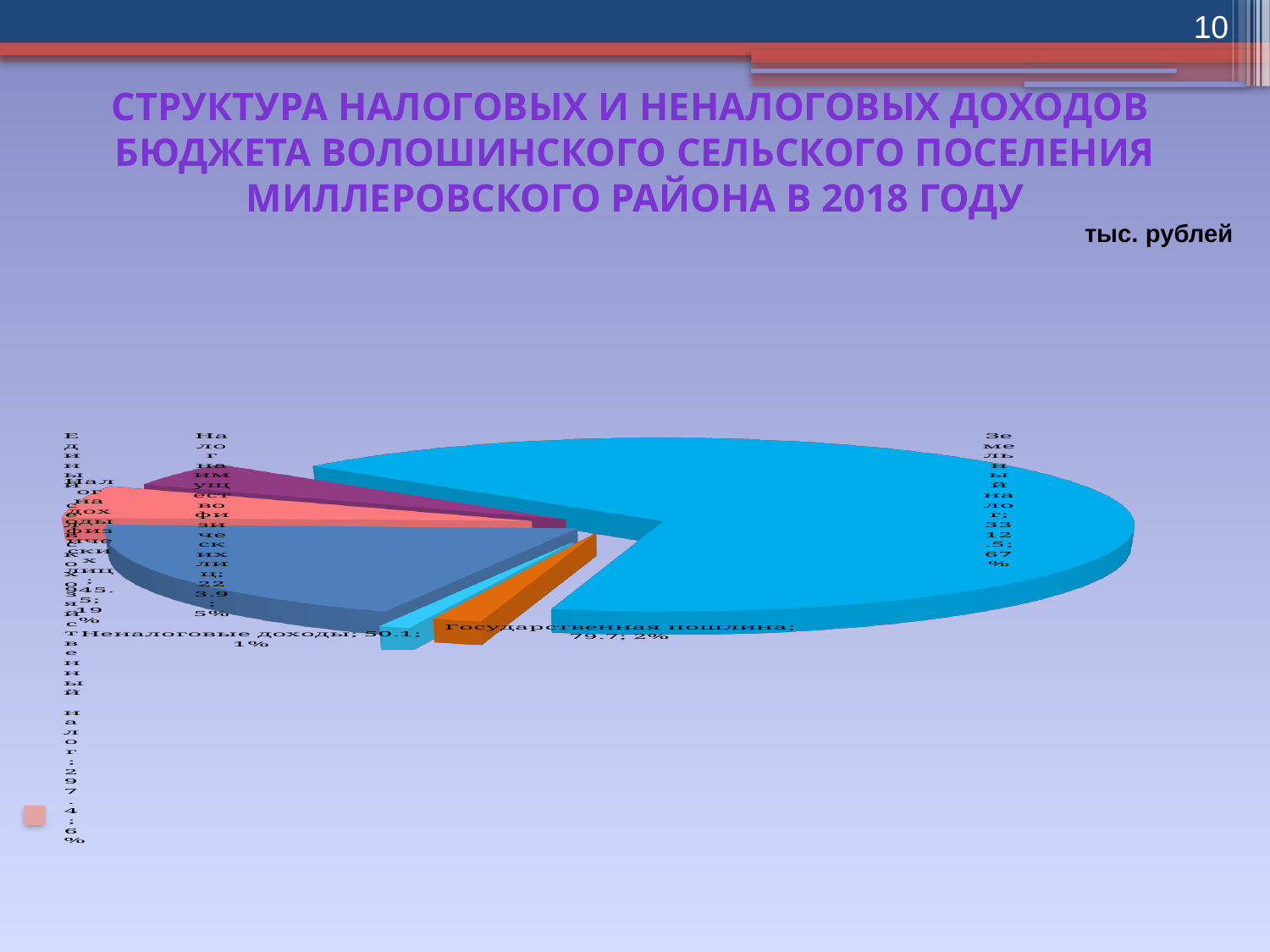
What is the difference between the values for Государственная пошлина and Неналоговые доходы? 29.6 What is the value shown for Государственная пошлина? 79.7 What share of the pie does Государственная пошлина have? 2% What is the value shown for Неналоговые доходы? 50.1 What kind of chart is shown on the slide? pie chart What is the value shown for Земельный налог? 3312.5 Which is larger, the value for Государственная пошлина or the value for Неналоговые доходы? Государственная пошлина What share of the pie does Единый сельскохозяйственный налог have? 6% What unit is stated for the values on the slide? тыс. рублей Which category has the largest share of the pie? Земельный налог What share of the pie does Земельный налог have? 67% Which category has the smallest share of the pie? Неналоговые доходы